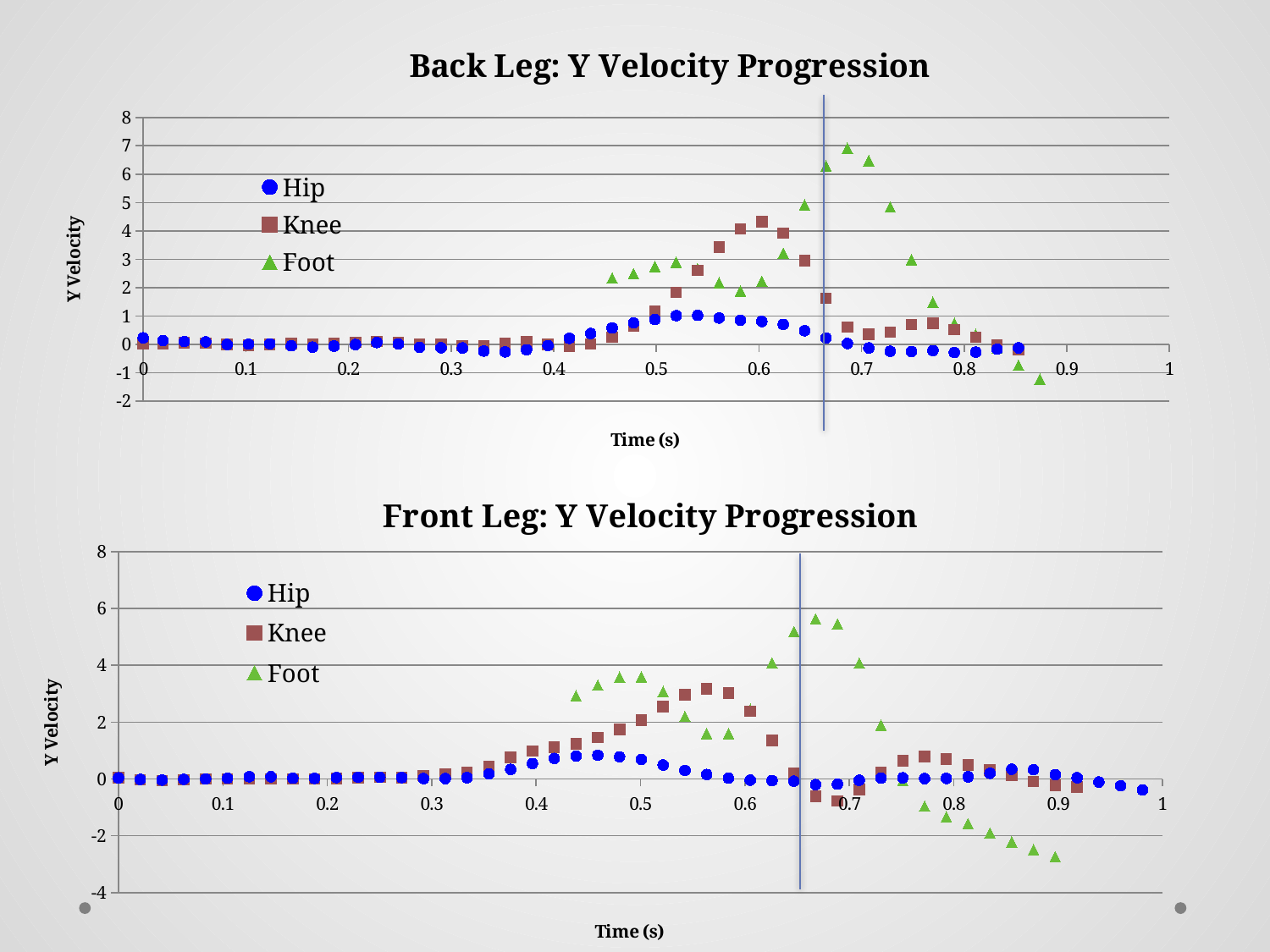
What kind of chart is the "Back Leg: Y Velocity Progression" chart? scatter chart What is the lowest tick value shown on the y axis of the "Front Leg: Y Velocity Progression" chart? -4 In the "Back Leg: Y Velocity Progression" chart, which series has the lowest peak Y velocity? Hip In the "Front Leg: Y Velocity Progression" chart, is the peak value of the Foot series greater or less than 4? greater In the "Front Leg: Y Velocity Progression" chart, is the lowest value of the Foot series greater or less than -2? less In the "Back Leg: Y Velocity Progression" chart, is the peak value of the Foot series greater or less than 6? greater In the "Back Leg: Y Velocity Progression" chart, which series reaches the highest Y velocity? Foot In the "Front Leg: Y Velocity Progression" chart, which series reaches the highest Y velocity? Foot In the "Front Leg: Y Velocity Progression" chart, which series has a higher peak, Knee or Hip? Knee What is the label of the x axis on the "Back Leg: Y Velocity Progression" chart? Time (s) How many series does the legend of the "Front Leg: Y Velocity Progression" chart list? 3